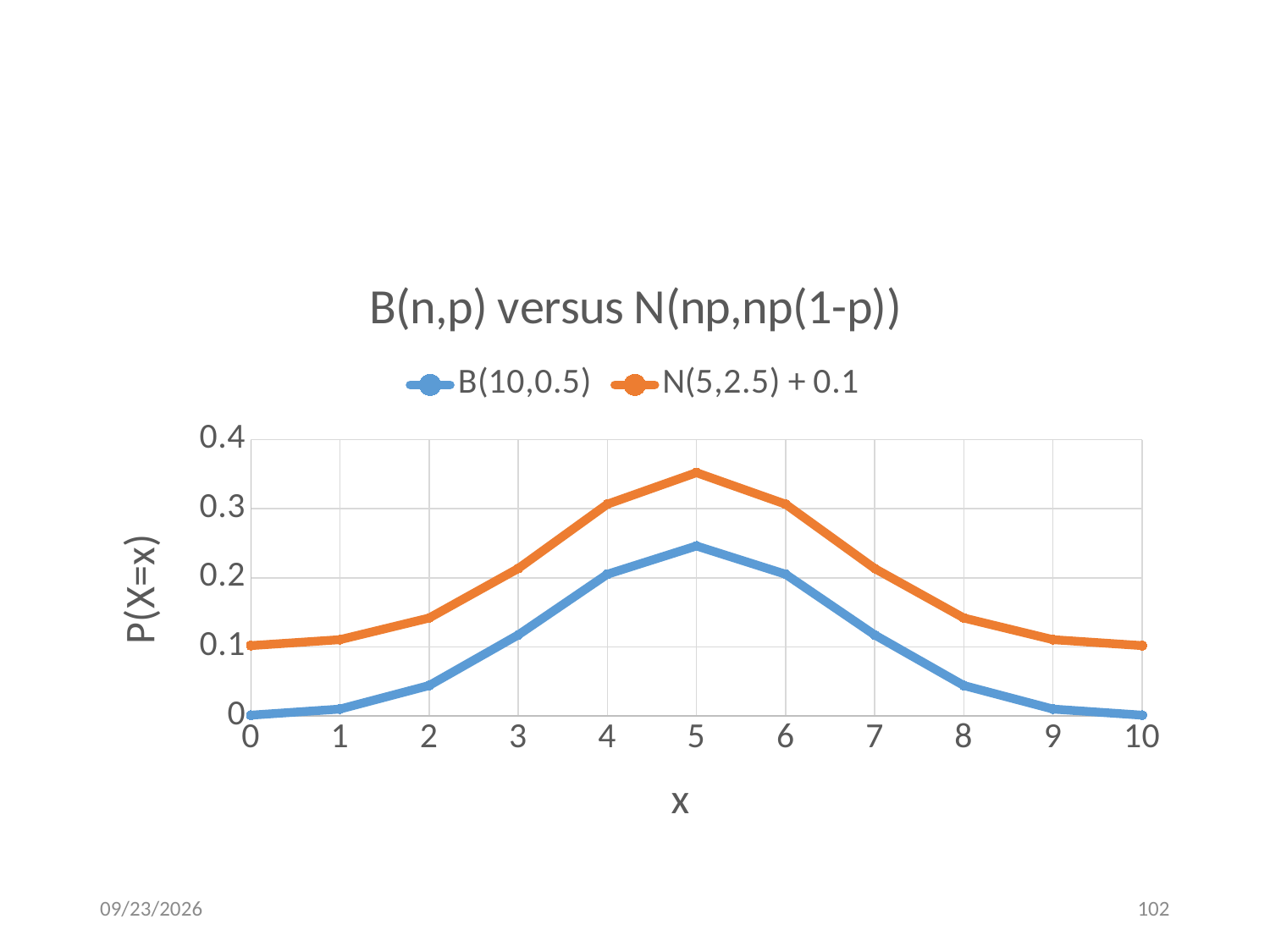
How many x values are plotted for each series? 11 Does the B(10,0.5) series rise or fall as x goes from 5 to 10? fall Is the value of B(10,0.5) at x = 5 greater or less than 0.2? greater What is the label on the vertical axis? P(X=x) At x = 5, which series has the larger value, B(10,0.5) or N(5,2.5) + 0.1? N(5,2.5) + 0.1 At which x value does the B(10,0.5) series reach its highest point? 5 How many series does the legend list? 2 At which x value does the N(5,2.5) + 0.1 series reach its highest point? 5 Is the value of B(10,0.5) at x = 2 greater or less than 0.1? less Is the value of N(5,2.5) + 0.1 at x = 5 greater or less than 0.3? greater What kind of chart is shown on the slide? line chart What is the title of the chart? B(n,p) versus N(np,np(1-p))